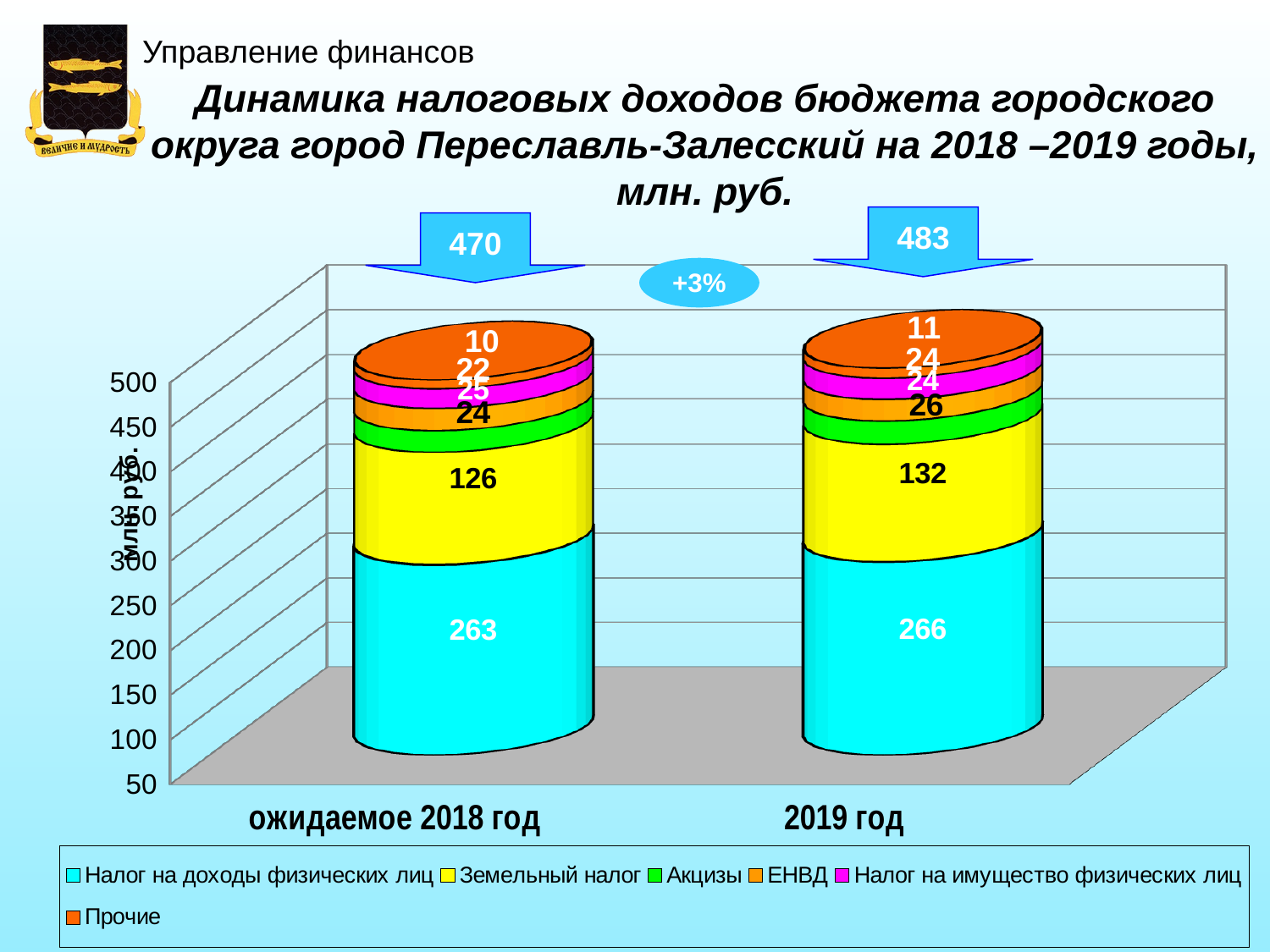
What is the value of Земельный налог for 2019 год? 132 Which series is shown in yellow in the legend? Земельный налог What is the value of Налог на доходы физических лиц for 2019 год? 266 What is the value of Прочие for ожидаемое 2018 год? 10 What is the value of Налог на доходы физических лиц for ожидаемое 2018 год? 263 How many series does the legend list? 6 Which year has the larger value for Налог на доходы физических лиц, ожидаемое 2018 год or 2019 год? 2019 год How many categories (years) are shown on the x axis? 2 What is the total of the stacked bar for 2019 год? 483 What is the difference in Земельный налог between 2019 год and ожидаемое 2018 год? 6 What is the difference between the totals for 2019 год and ожидаемое 2018 год? 13 What kind of chart is shown on the slide? stacked bar chart